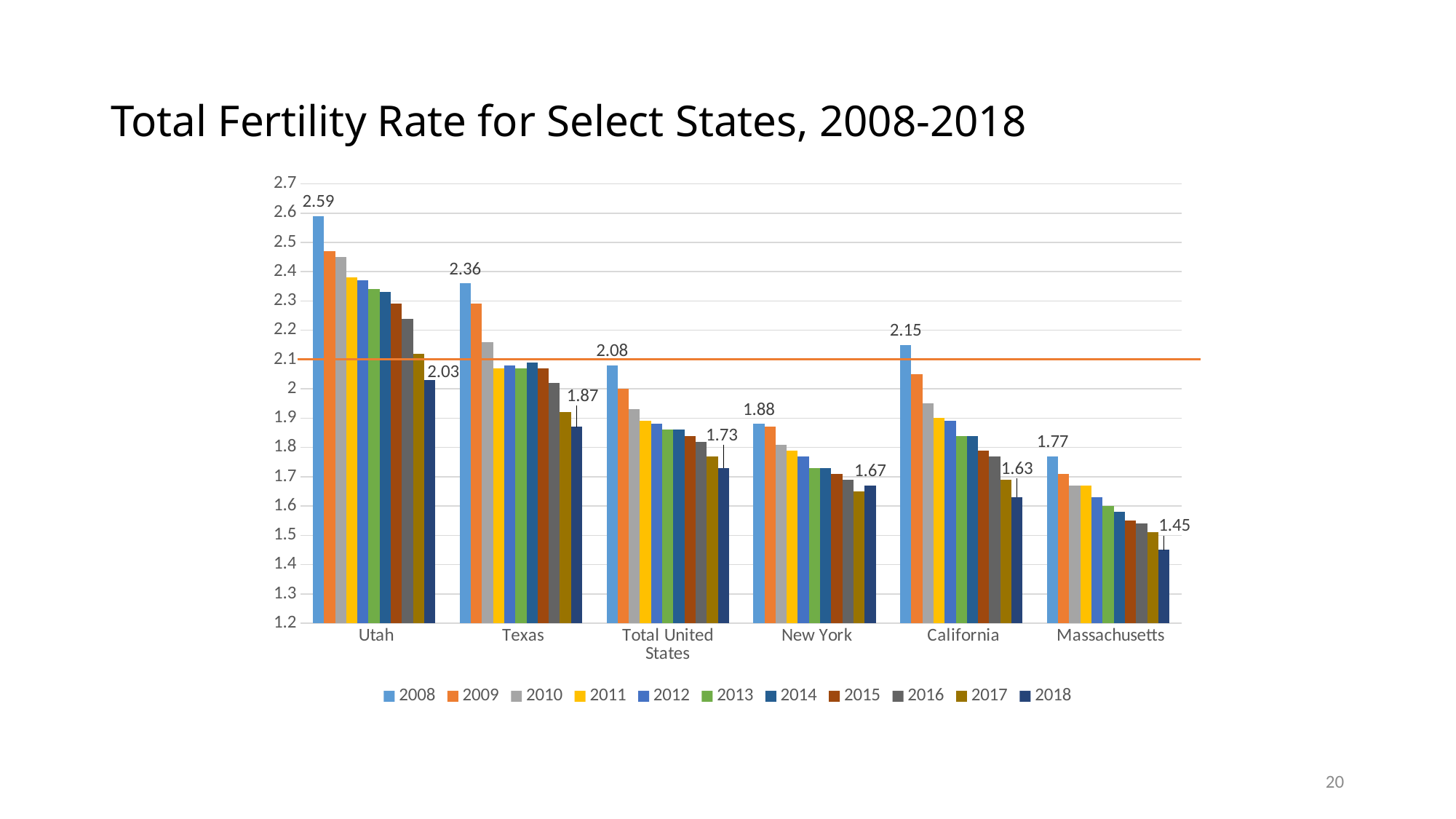
Is the 2010 value for Texas greater or less than 2.1? greater What is the title of the chart? Total Fertility Rate for Select States, 2008-2018 Which category has the lowest 2018 total fertility rate? Massachusetts What is the 2008 total fertility rate for Utah? 2.59 What is the difference between Utah's 2008 value and its 2018 value? 0.56 How many states or categories are shown on the x axis? 6 Which state has the highest 2008 total fertility rate? Utah Which is larger: California's 2008 value or New York's 2008 value? California's 2008 value What is the 2018 value for Texas? 1.87 What kind of chart is shown on the slide? Bar chart How many series does the legend list? 11 What is the 2018 total fertility rate for Massachusetts? 1.45